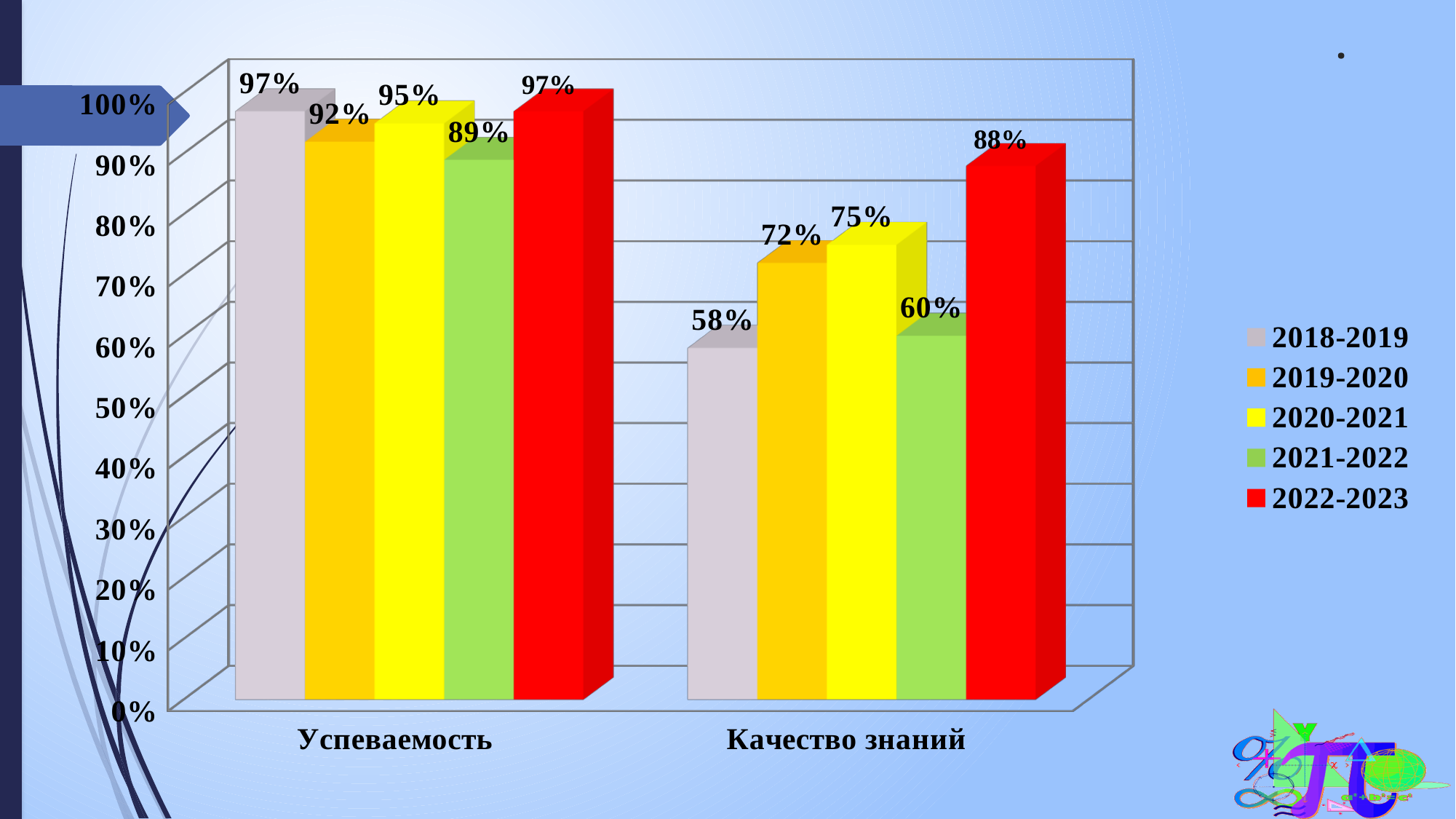
Which series has the lowest value in the Качество знаний category? 2018-2019 What is the difference between the 2022-2023 and 2018-2019 values in the Качество знаний category? 30% What is the value for 2018-2019 in the Качество знаний category? 58% Which is larger: the 2020-2021 value for Успеваемость or the 2020-2021 value for Качество знаний? Успеваемость Which colour represents the 2022-2023 series in the legend? Red What kind of chart is shown on the slide? Bar chart What is the value for 2021-2022 in the Успеваемость category? 89% What is the value for 2022-2023 in the Качество знаний category? 88% How many categories are shown on the x axis? 2 Which series has the lowest value in the Успеваемость category? 2021-2022 How many series does the legend list? 5 What is the value for 2019-2020 in the Успеваемость category? 92%